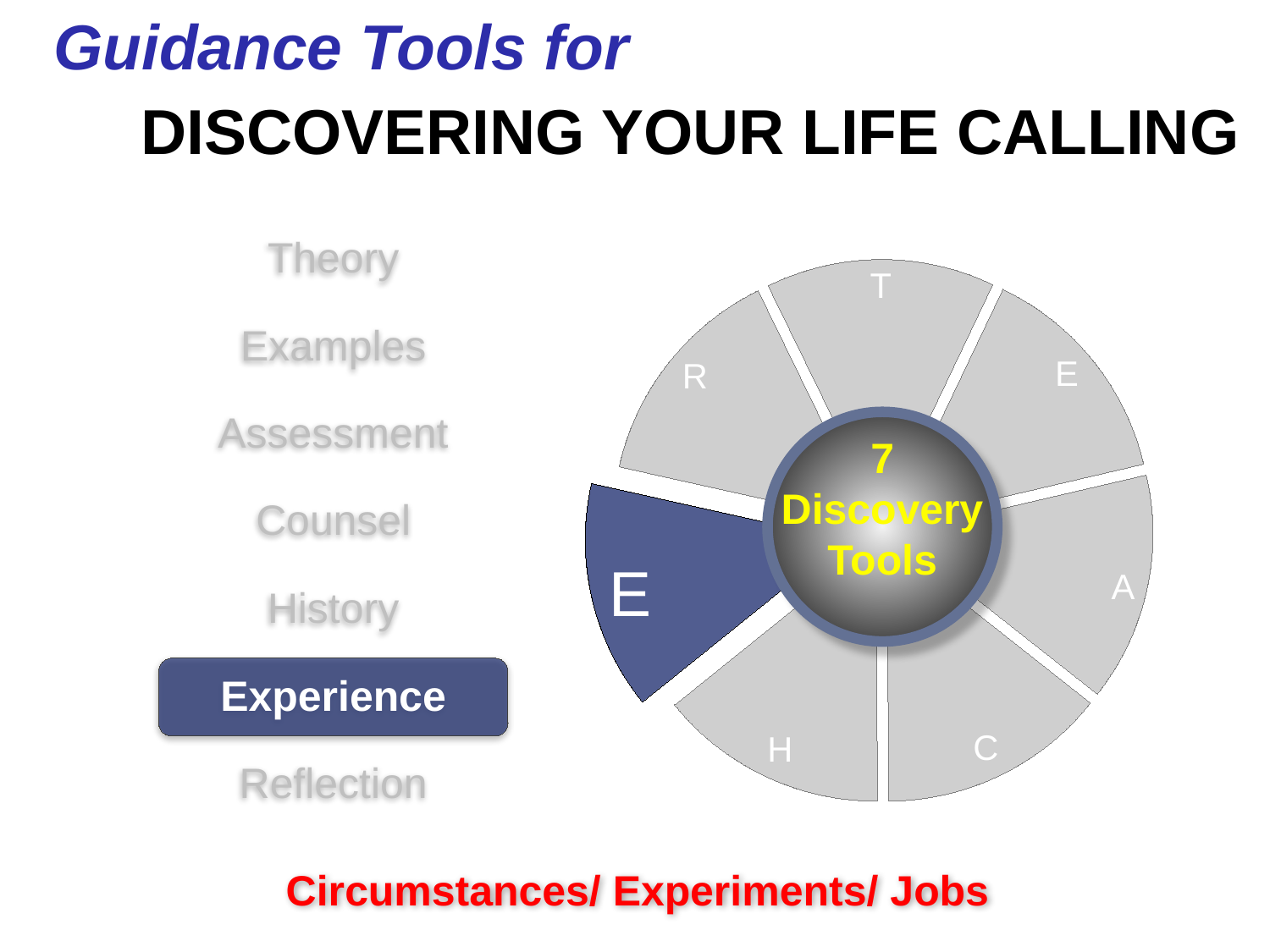
What letter is shown in the top segment of the wheel diagram? T Which item in the left-hand list is highlighted with a dark blue box? Experience How many segments does the wheel diagram on the right have? 7 What letter is shown in the bottom-right segment of the wheel diagram? C What text is written in the centre of the wheel diagram? 7 Discovery Tools Which segment of the wheel diagram is highlighted in dark blue? E